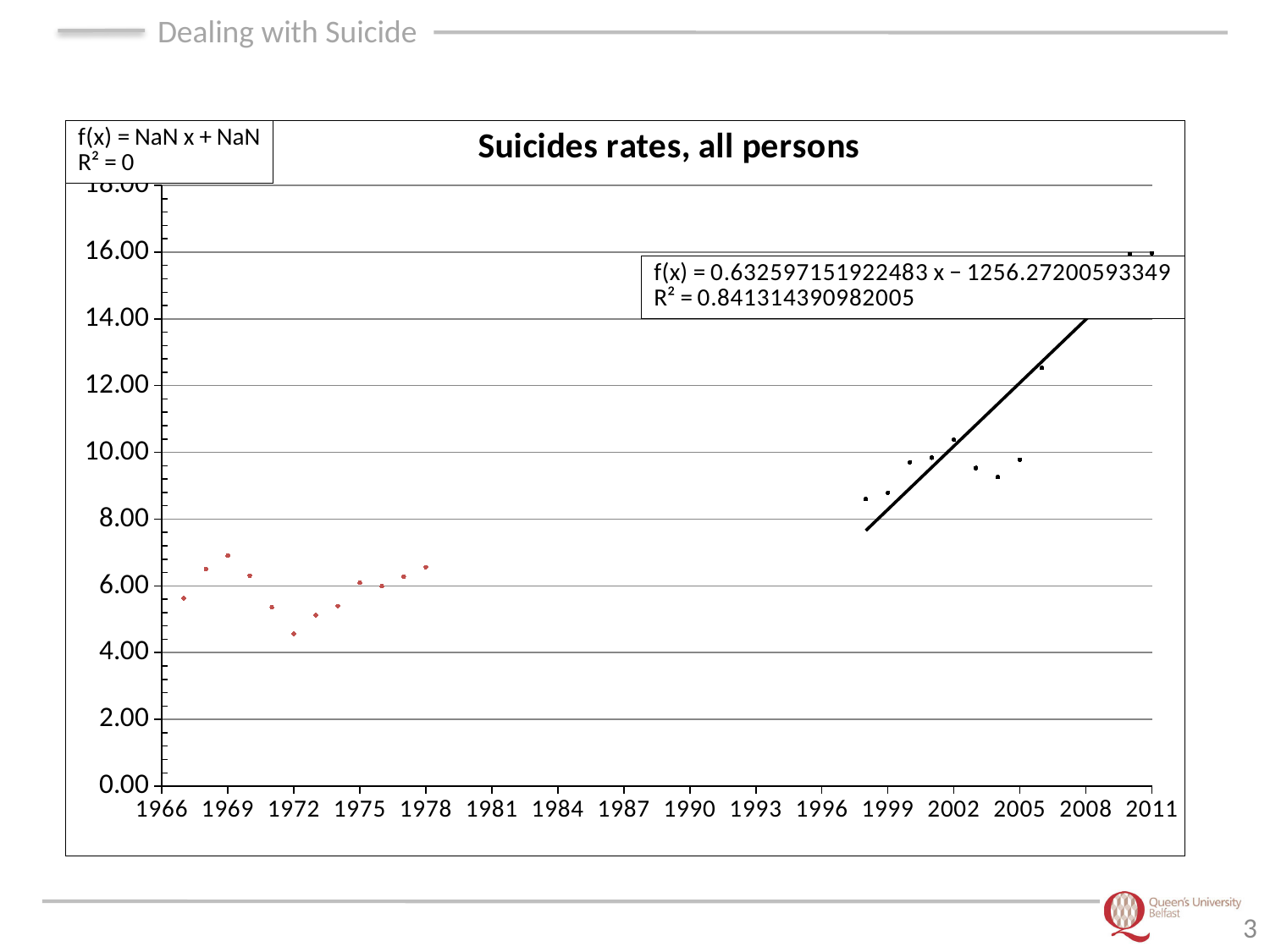
What is the slope (coefficient of x) in the trendline equation shown on the chart? 0.632597151922483 Do the black data points from 1998 onwards generally rise or fall over time? rise What R² value is shown for the trendline fitted to the later (black) data points? 0.841314390982005 Is the value plotted for 1967 greater or less than 8.00? less What is the highest value shown on the vertical axis? 18.00 Which year has the lowest plotted value on the chart? 1972 Is the value plotted for 2011 greater or less than 14.00? greater Is the value plotted for 1972 greater or less than 6.00? less What kind of chart is shown on the slide? scatter chart What is the title of the chart? Suicides rates, all persons Which is larger, the value plotted for 2011 or the value plotted for 1969? 2011